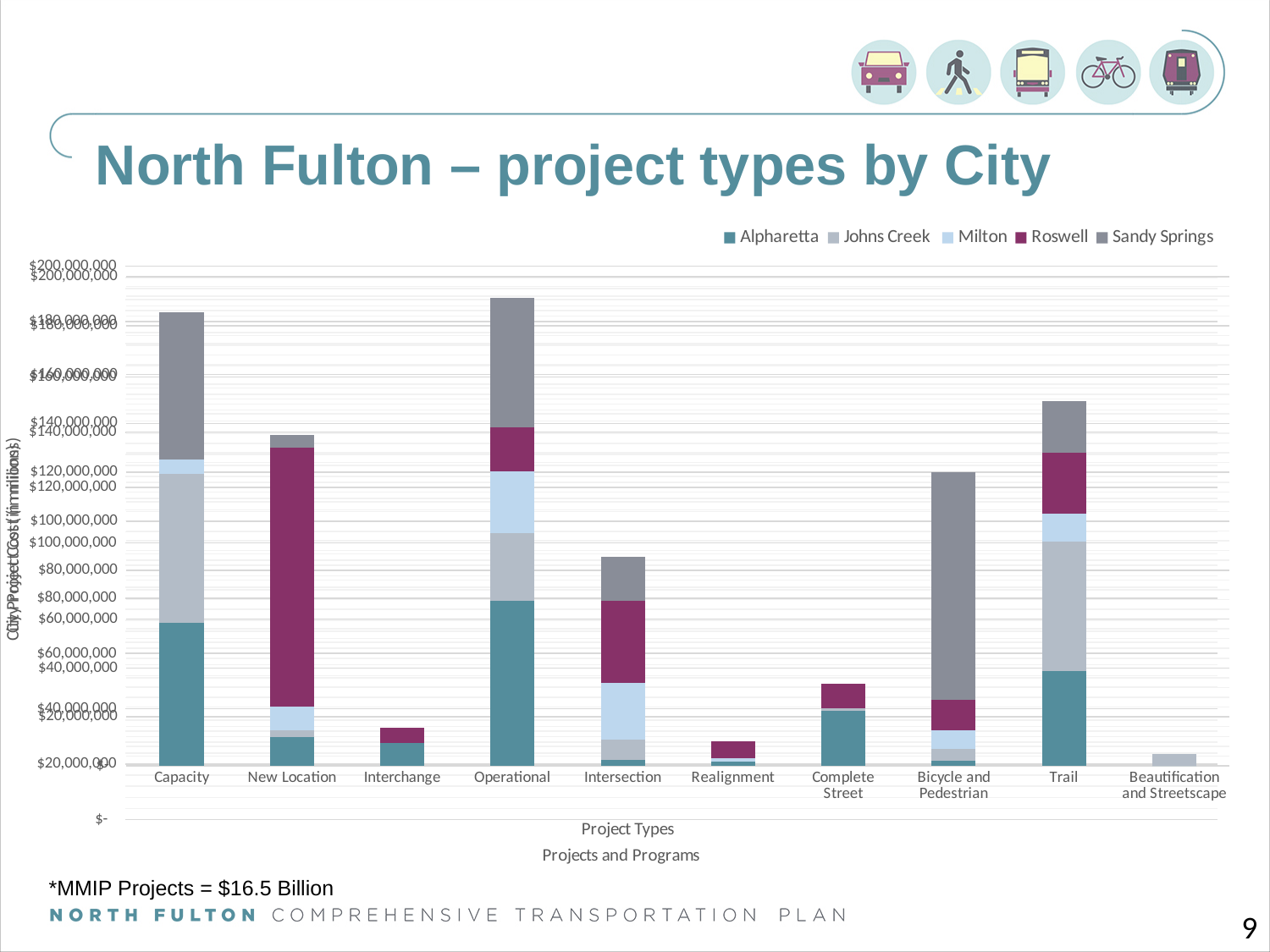
Which city accounts for most of the Bicycle and Pedestrian bar? Sandy Springs Which stacked bar is taller, Trail or Bicycle and Pedestrian? Trail How many project type categories are shown on the x axis? 10 Is the total value for Operational greater or less than $100,000,000? greater What is the title of the slide? North Fulton – project types by City How many cities does the legend list? 5 Which project type has the tallest stacked bar? Operational Which project type has the shortest stacked bar? Beautification and Streetscape Which city accounts for most of the New Location bar? Roswell What type of chart is shown on the slide? Stacked bar chart Which stacked bar is taller, New Location or Intersection? New Location Is the total value for Realignment greater or less than $40,000,000? less